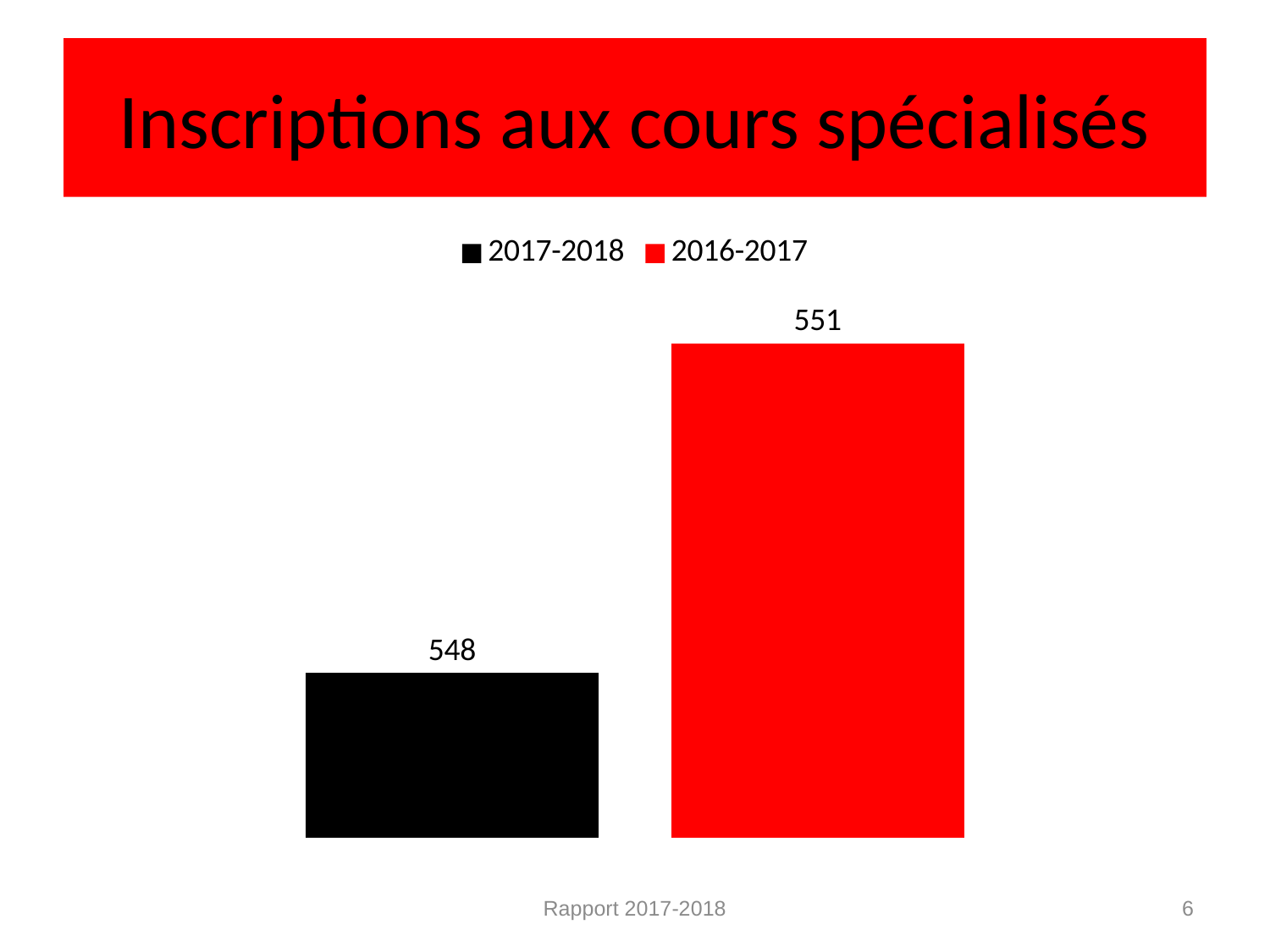
How many bars are plotted on the chart? 2 What is the difference between the 2016-2017 value and the 2017-2018 value? 3 How many series does the legend list? 2 Which series has the lowest value? 2017-2018 What is the value for 2017-2018? 548 What is the title of the slide containing the chart? Inscriptions aux cours spécialisés What colour is the bar for 2016-2017? red What kind of chart is shown on the slide? bar chart What is the value for 2016-2017? 551 Which series has the higher value, 2017-2018 or 2016-2017? 2016-2017